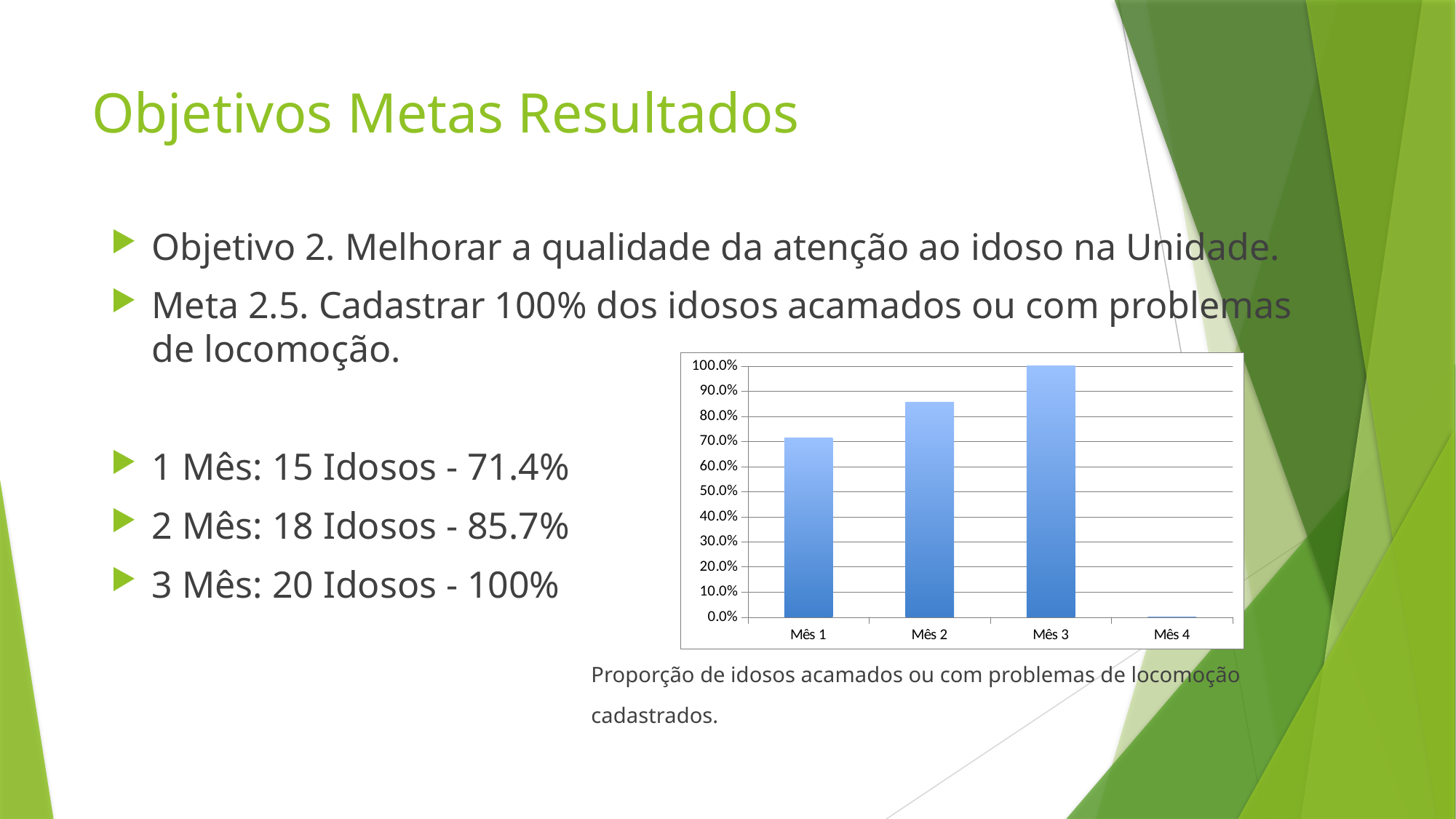
Is the value for Mês 2 greater or less than 80.0%? greater Do the values rise or fall from Mês 1 to Mês 3? rise Which month has the lowest bar in the chart? Mês 4 Is the value for Mês 1 greater or less than 80.0%? less How many categories are shown on the x axis of the chart? 4 What is the highest tick value shown on the y axis of the chart? 100.0% What is the value for Mês 4 in the chart? 0.0% Which month has the highest bar in the chart? Mês 3 What kind of chart is shown on the slide? bar chart What is the value for Mês 3 in the chart? 100.0% Is the value for Mês 1 greater or less than 60.0%? greater Which is larger, the value for Mês 2 or the value for Mês 1? Mês 2